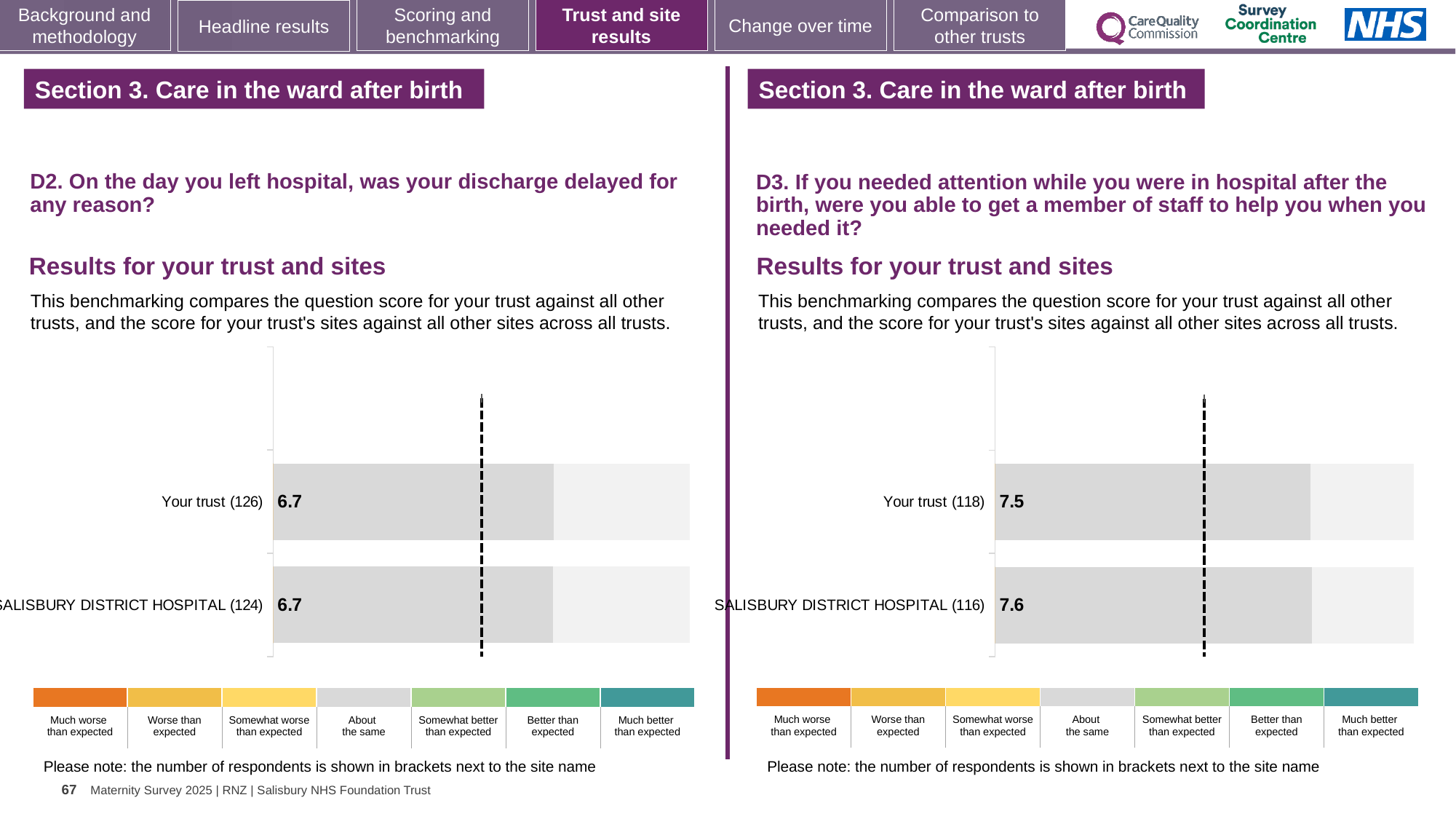
In the D3 chart on the right, which has the higher score: Your trust or Salisbury District Hospital? Salisbury District Hospital In the D2 chart on the left, how many respondents are shown in brackets for Your trust? 126 In the D3 chart on the right, what is the difference between the Salisbury District Hospital score and the Your trust score? 0.1 In the D3 chart on the right, how many respondents are shown in brackets for Salisbury District Hospital? 116 In the D3 chart on the right, what is the score for Your trust? 7.5 What type of chart is used for the D3 results on the right? Bar chart In the D3 chart on the right, what is the score for Salisbury District Hospital? 7.6 In the D2 chart on the left, what is the score for Your trust? 6.7 In the D2 chart on the left, what is the score for Salisbury District Hospital? 6.7 How many bars are plotted in the D2 chart on the left? 2 In the D2 chart on the left, what is the difference between the Your trust score and the Salisbury District Hospital score? 0